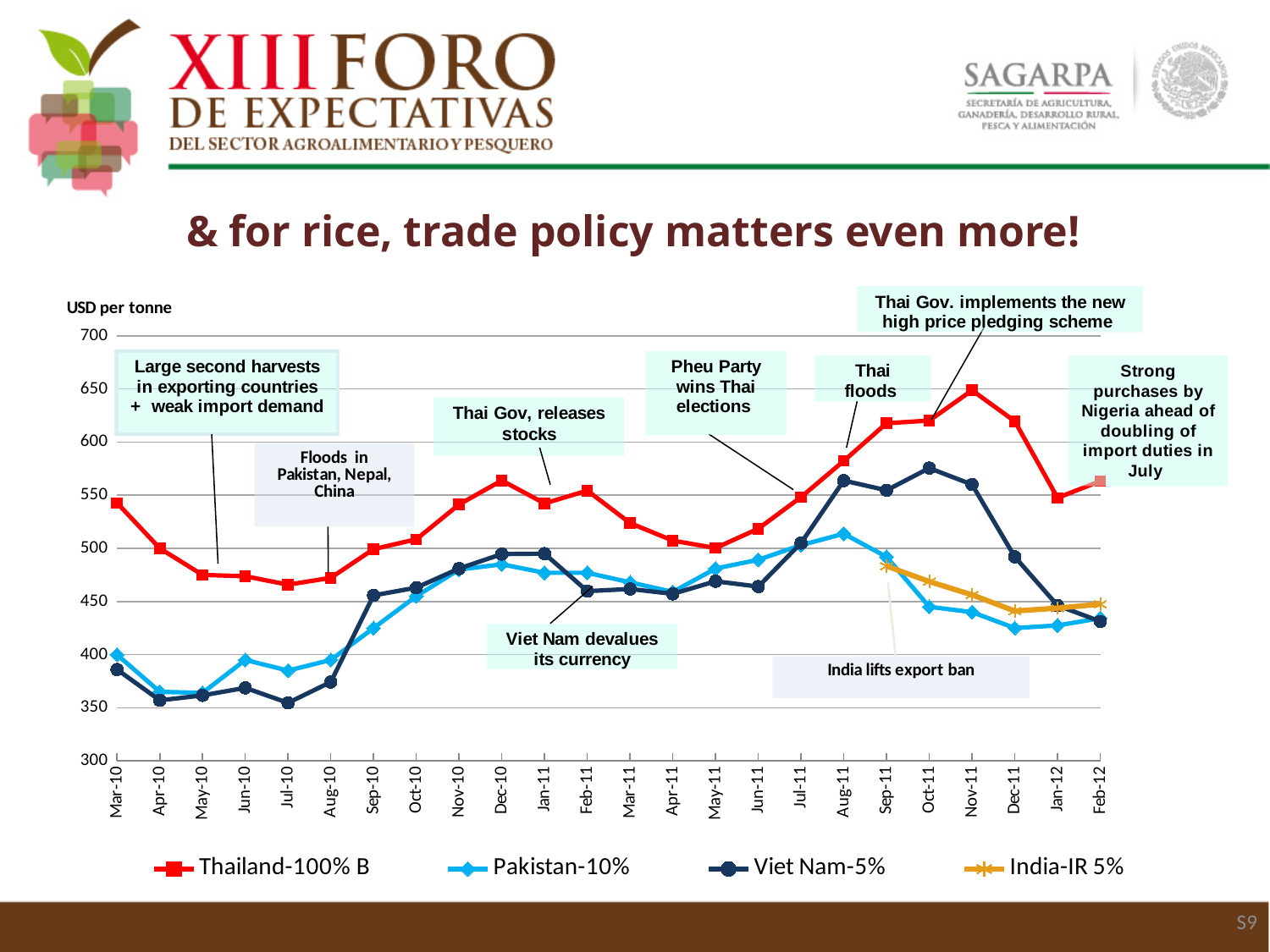
Which series has the highest value in Nov-11? Thailand-100% B In which month does the Thailand-100% B series reach its highest value? Nov-11 Is the value for Pakistan-10% in Dec-11 greater or less than 450? less Is the value for Thailand-100% B in Nov-11 greater or less than 600? greater How many months are plotted along the x axis? 24 What kind of chart is shown on the slide? Line chart What unit is shown on the y axis label of the chart? USD per tonne Does the Thailand-100% B series rise or fall from Nov-11 to Jan-12? Fall Which is larger in Jul-10, the value for Pakistan-10% or the value for Viet Nam-5%? Pakistan-10% Is the value for Viet Nam-5% in Jul-10 greater or less than 400? less How many series does the legend list? 4 In which month does the Viet Nam-5% series reach its lowest value? Jul-10